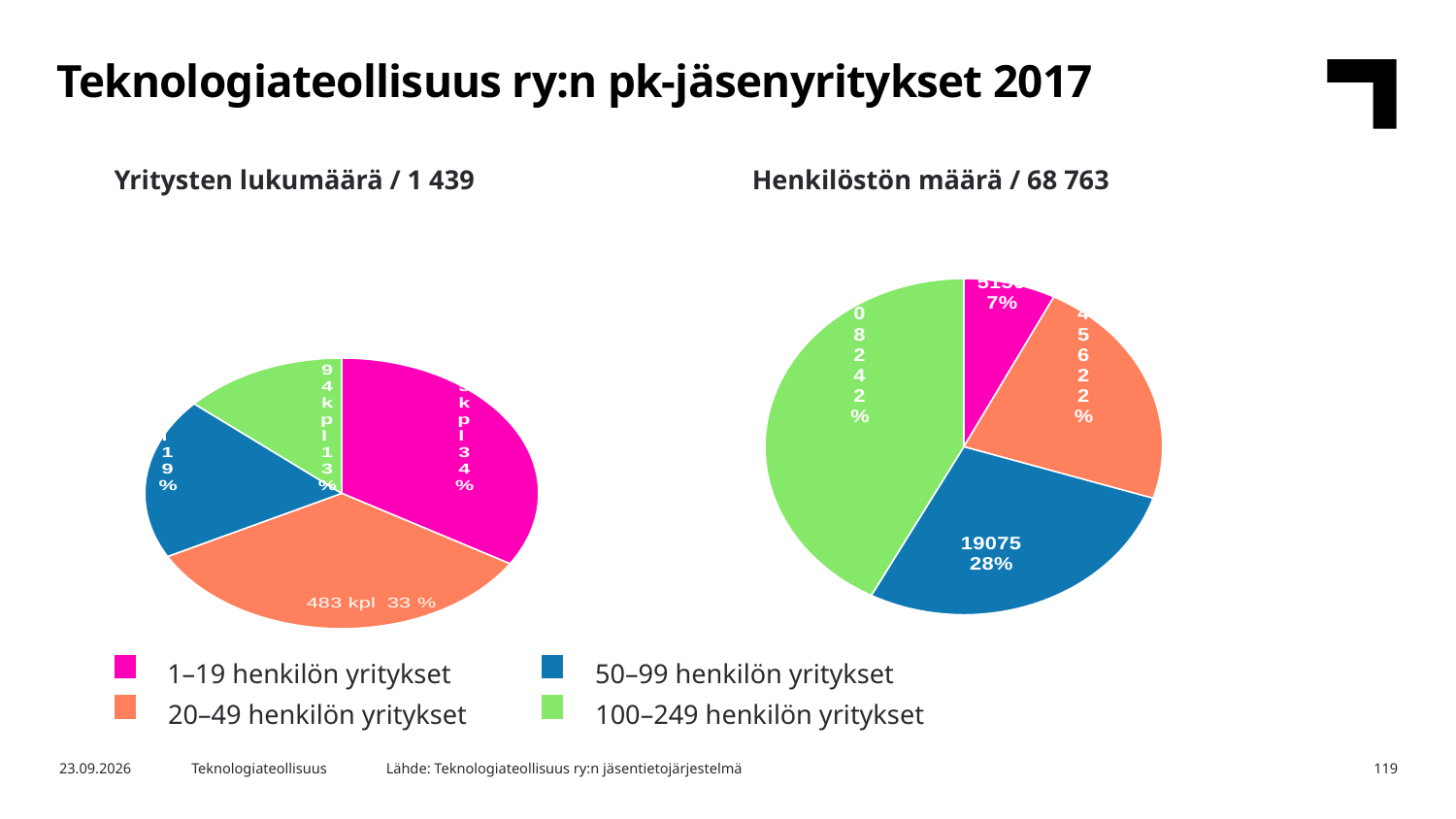
In the right chart (Henkilöstön määrä / 68 763), which category has the largest share? 100–249 henkilön yritykset In the left chart (Yritysten lukumäärä / 1 439), which category has the largest share? 1–19 henkilön yritykset Which colour represents the 20–49 henkilön yritykset in the charts? Orange How many company size categories does the legend list? 4 In the left chart (Yritysten lukumäärä / 1 439), which category has the smallest share? 100–249 henkilön yritykset In the left chart (Yritysten lukumäärä / 1 439), what share of the pie do the 50–99 henkilön yritykset have? 19 % What kind of chart is used on this slide? Pie chart In the right chart (Henkilöstön määrä / 68 763), what is the personnel count for the 50–99 henkilön yritykset? 19075 In the right chart (Henkilöstön määrä / 68 763), what share of the pie do the 50–99 henkilön yritykset have? 28% In the right chart (Henkilöstön määrä / 68 763), which category has the smallest share? 1–19 henkilön yritykset In the left chart (Yritysten lukumäärä / 1 439), how many companies (kpl) are in the 20–49 henkilön yritykset category? 483 kpl In the left chart (Yritysten lukumäärä / 1 439), what share of the pie do the 20–49 henkilön yritykset have? 33 %